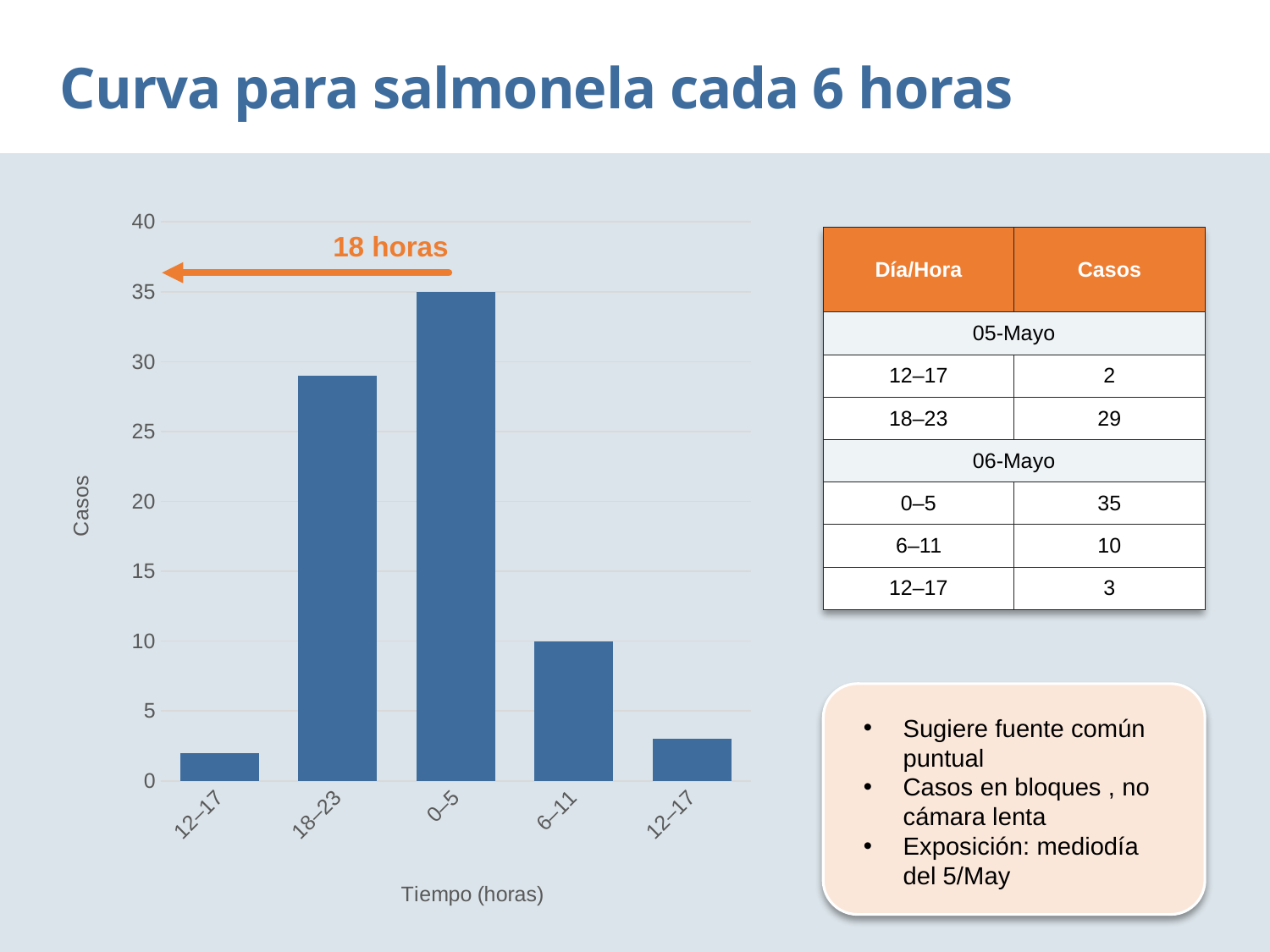
Which is larger, the value for 18–23 or the value for 6–11? 18–23 What is the value for the first 12–17 interval (05-Mayo)? 2 What kind of chart is shown on the slide? bar chart What is the value for the 6–11 interval? 10 Is the value for the 18–23 interval greater or less than 25? greater What is the value for the 18–23 interval? 29 What is the label of the y axis? Casos What is the difference in cases between the 0–5 interval and the 18–23 interval? 6 What is the label of the x axis? Tiempo (horas) How many bars does the chart have? 5 Which time interval has the highest number of cases? 0–5 What is the value for the 0–5 interval? 35